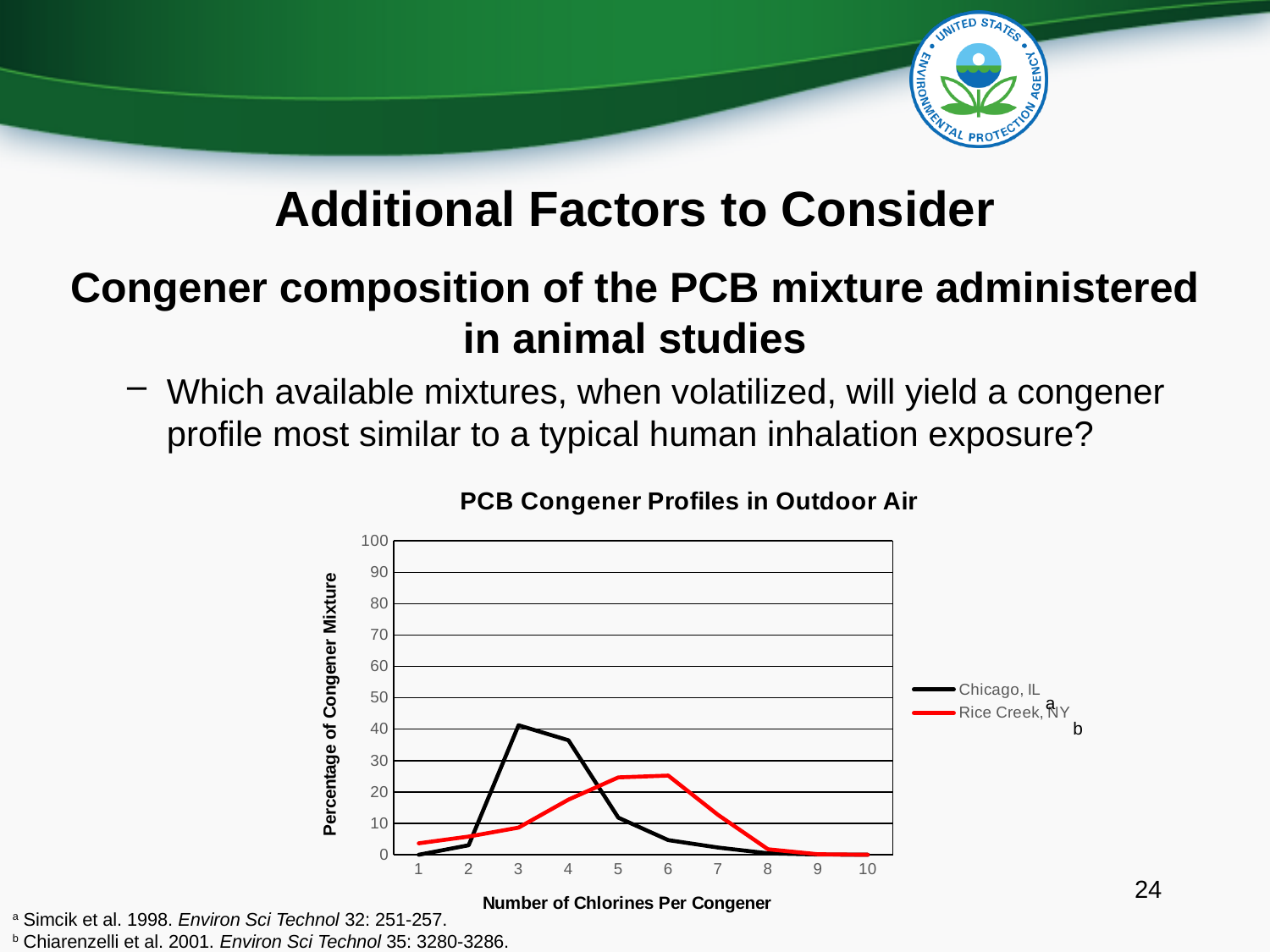
At which number of chlorines per congener does the Chicago, IL series reach its highest value? 3 Does the Chicago, IL series rise or fall from 3 to 10 chlorines per congener? fall What kind of chart is shown on the slide? line chart Is the Rice Creek, NY value at 6 chlorines per congener greater or less than 30? less How many values are shown on the x axis (Number of Chlorines Per Congener)? 10 What is the title of the chart? PCB Congener Profiles in Outdoor Air Is the Chicago, IL value at 3 chlorines per congener greater or less than 30? greater Which series has the larger value at 7 chlorines per congener, Chicago, IL or Rice Creek, NY? Rice Creek, NY How many series does the legend list? 2 What colour is the line for Rice Creek, NY? red Is the Chicago, IL value at 7 chlorines per congener greater or less than 10? less Which series has the larger value at 3 chlorines per congener, Chicago, IL or Rice Creek, NY? Chicago, IL